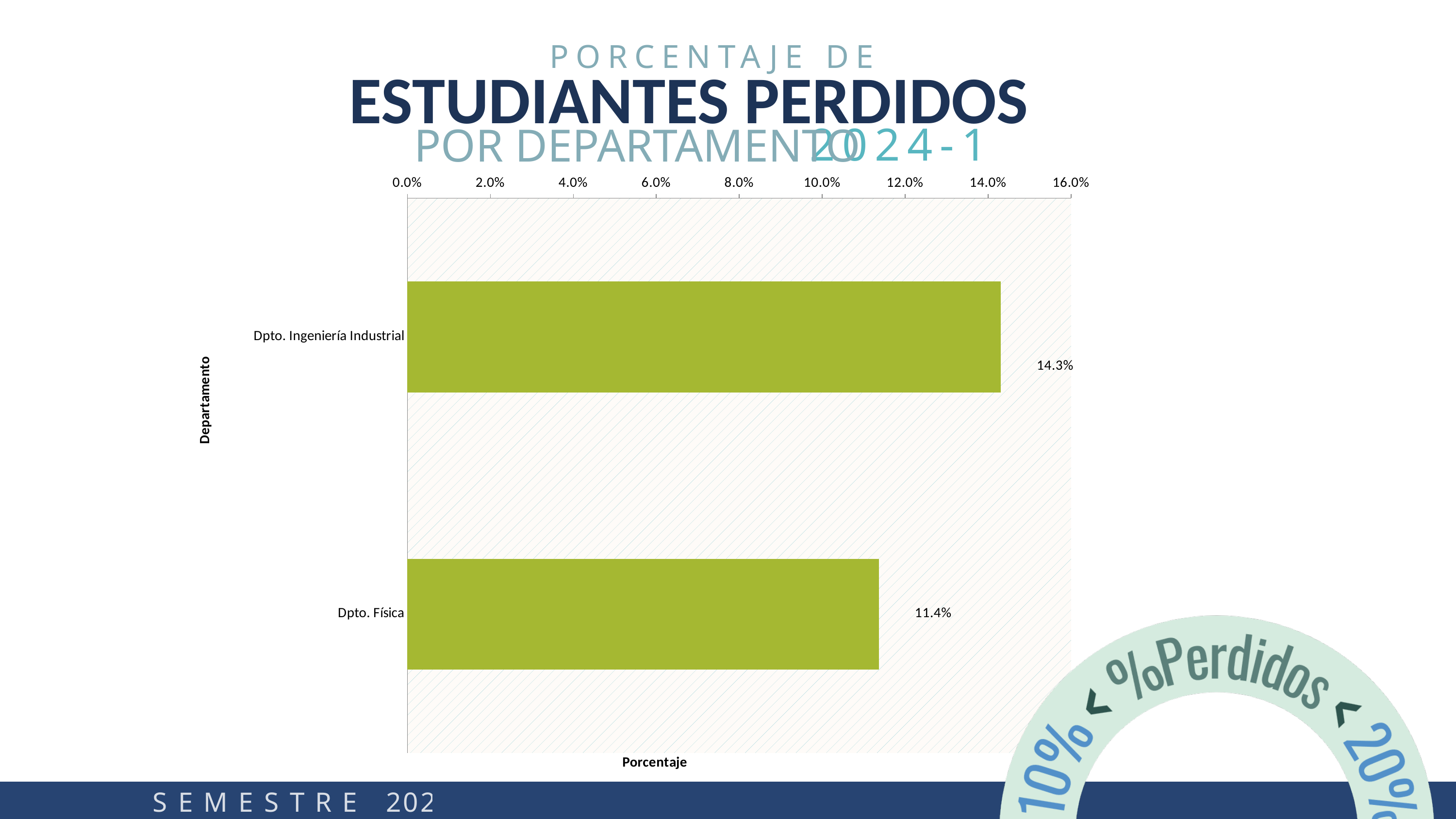
What is the label of the vertical axis? Departamento What is the value for Dpto. Ingeniería Industrial? 14.3% Is the value for Dpto. Física greater or less than 12.0%? less What kind of chart is shown on the slide? bar chart What is the difference between the values for Dpto. Ingeniería Industrial and Dpto. Física? 2.9% How many departments are shown in the chart? 2 What is the value for Dpto. Física? 11.4% Is the value for Dpto. Ingeniería Industrial greater or less than 14.0%? greater What is the label of the horizontal axis? Porcentaje Which department has the highest percentage of lost students? Dpto. Ingeniería Industrial Which is larger, the value for Dpto. Física or the value for Dpto. Ingeniería Industrial? Dpto. Ingeniería Industrial Which department has the lowest percentage of lost students? Dpto. Física